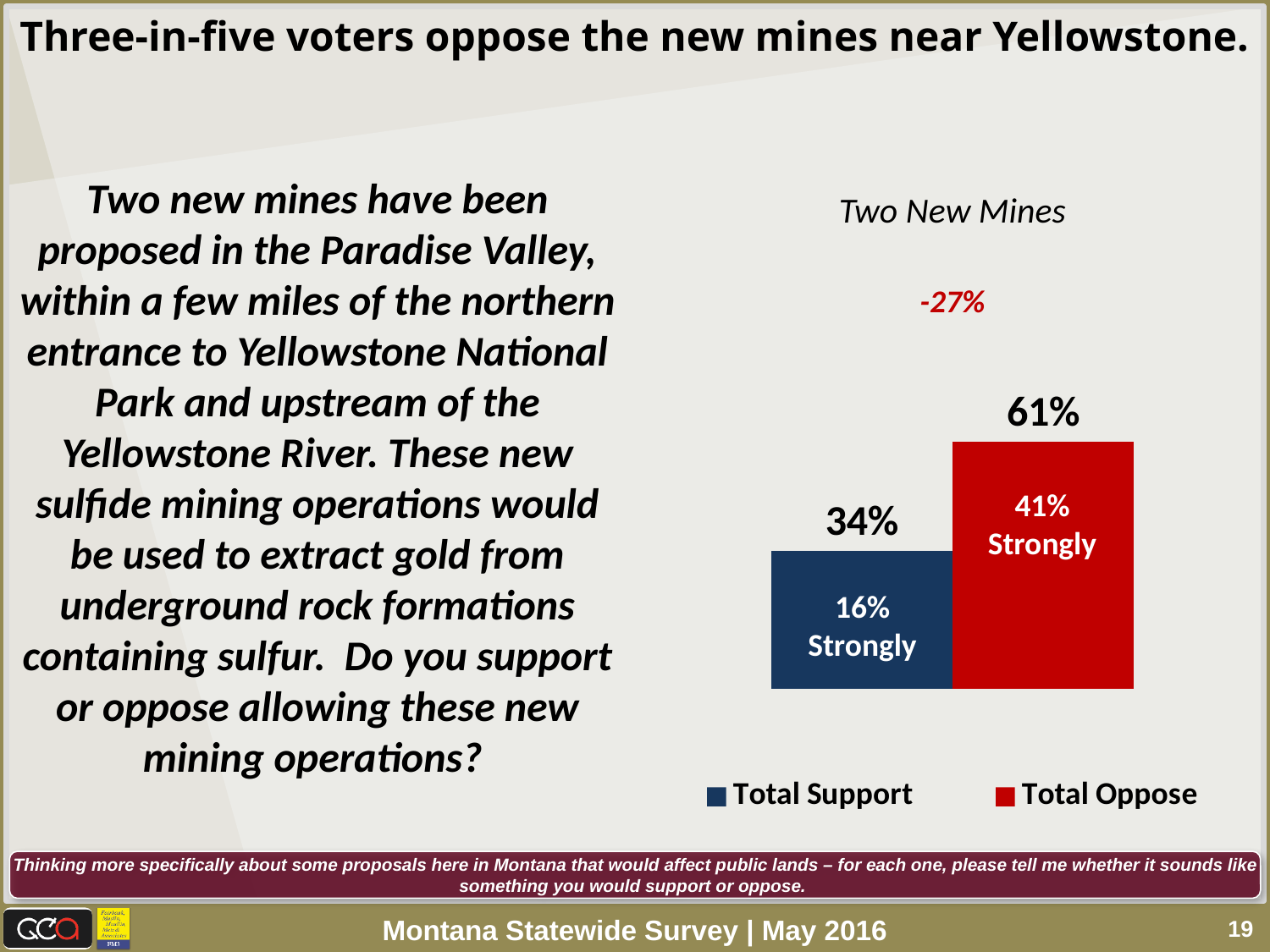
What colour is the Total Oppose bar in the chart? Red How many bars are plotted in the chart? 2 What net figure is printed above the bars in the chart? -27% Which is larger in the chart, Total Support or Total Oppose? Total Oppose What is the Total Oppose value in the Two New Mines chart? 61% How many series does the chart legend list? 2 What kind of chart is shown on the slide? Bar chart What is the difference between Total Oppose and Total Support in the chart? 27% What share of voters strongly oppose the new mines, according to the chart? 41% What is the Total Support value in the Two New Mines chart? 34% What is the title of the chart? Two New Mines What share of voters strongly support the new mines, according to the chart? 16%